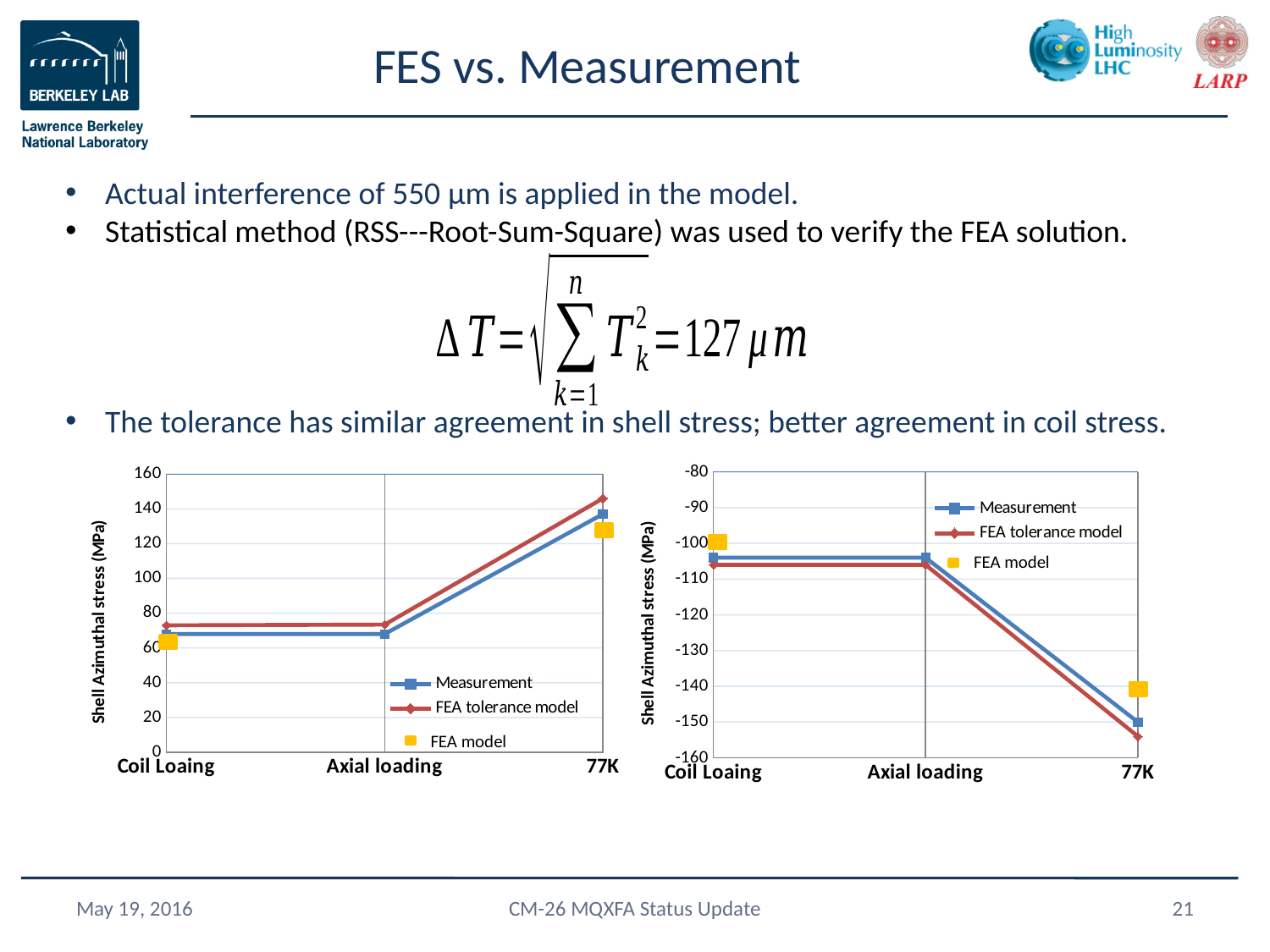
In the right chart, is the FEA model value at 77K greater or less than -130? less In the right chart, does the Measurement series rise or fall from Axial loading to 77K? fall In the right chart, is the Measurement value at 77K greater or less than -140? less In the left chart, at which category does the Measurement series reach its highest value? 77K In the left chart, at 77K, which is larger: the Measurement value or the FEA tolerance model value? FEA tolerance model What is the y-axis title of the left chart? Shell Azimuthal stress (MPa) How many series does the legend of the left chart list? 3 In the left chart, is the Measurement value at 77K greater or less than 120? greater How many categories are shown on the x axis of the right chart? 3 What kind of chart is the left chart (Shell Azimuthal stress, 0 to 160 axis)? line chart